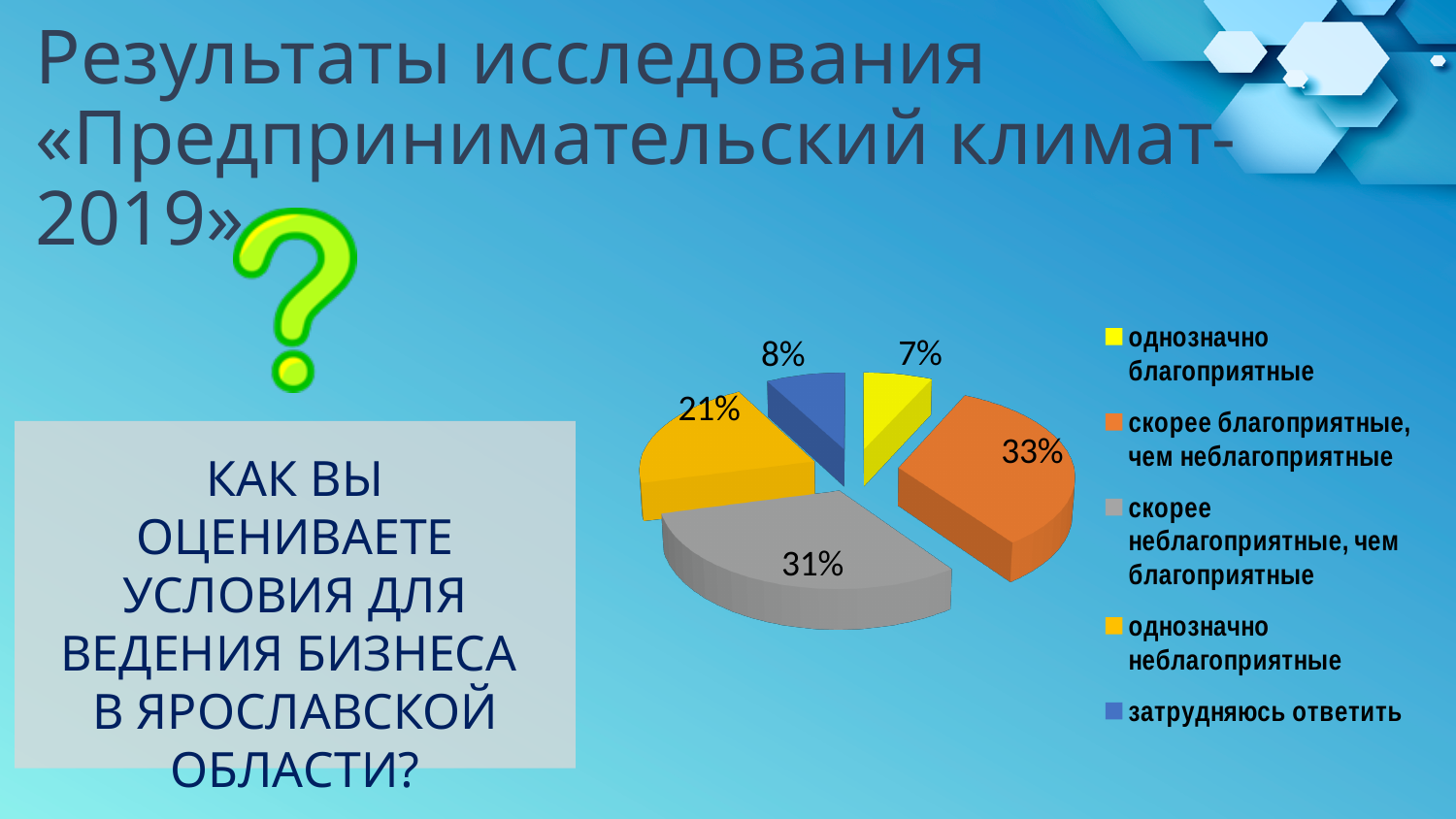
What share of respondents answered «затрудняюсь ответить»? 8% Which answer option has the smallest share in the pie chart? однозначно благоприятные Which is larger: the share for «однозначно неблагоприятные» or the share for «затрудняюсь ответить»? однозначно неблагоприятные Which answer option has the largest share in the pie chart? скорее благоприятные, чем неблагоприятные What share of respondents answered «скорее неблагоприятные, чем благоприятные»? 31% What share of respondents answered «однозначно благоприятные»? 7% What share of respondents answered «однозначно неблагоприятные»? 21% What is the difference between the shares for «скорее неблагоприятные, чем благоприятные» and «однозначно неблагоприятные»? 10% How many answer options (slices) does the pie chart show? 5 What share of respondents answered «скорее благоприятные, чем неблагоприятные»? 33% What kind of chart is shown on the slide? pie chart What colour is the slice for «затрудняюсь ответить»? blue